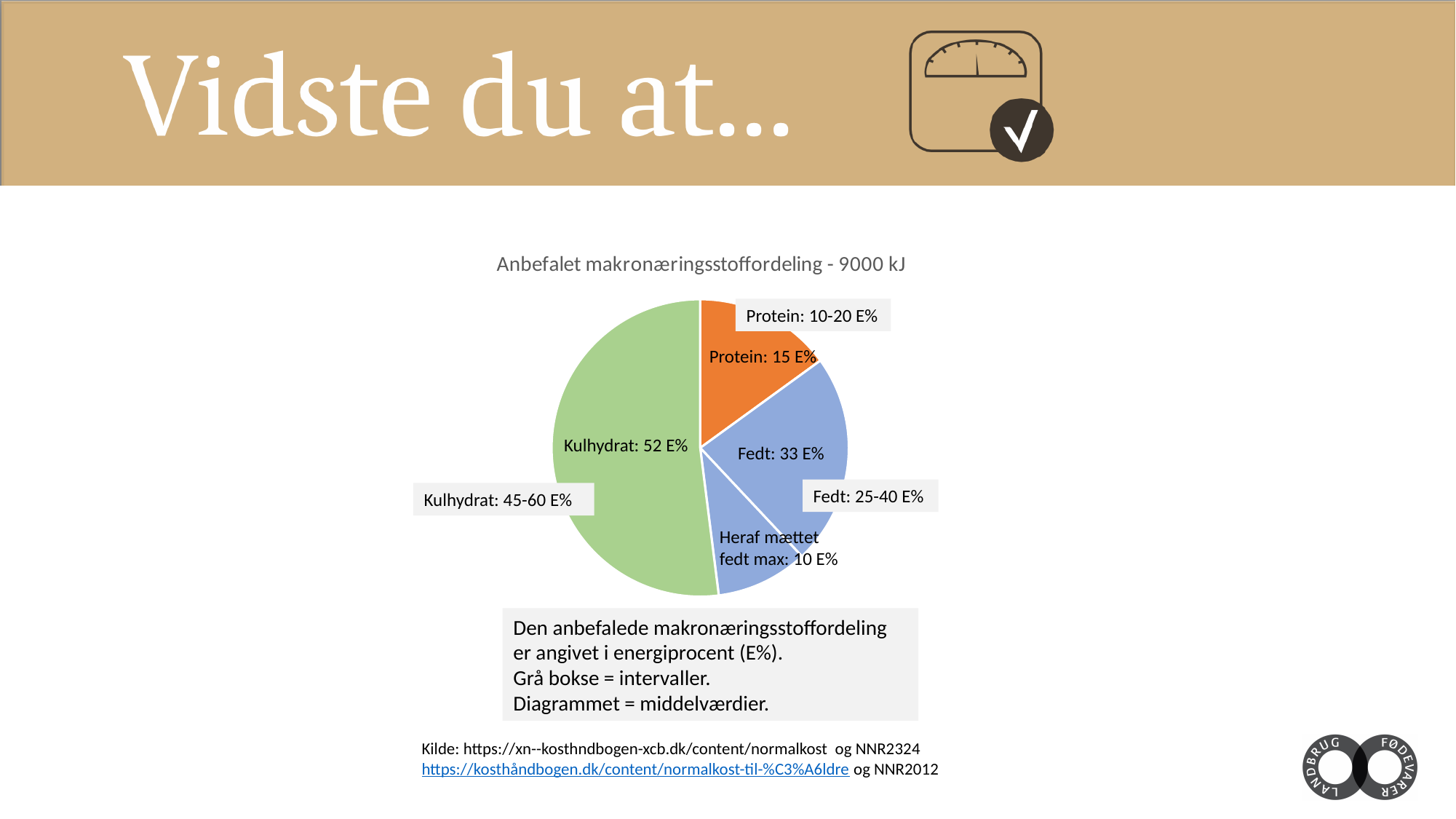
What is the maximum value given for 'Heraf mættet fedt' in the pie chart? 10 E% Which macronutrient has the largest slice of the pie chart? Kulhydrat What is the difference between the Kulhydrat value and the Fedt value in the pie chart? 19 E% What value is shown for Kulhydrat in the pie chart? 52 E% What share of the pie does Kulhydrat represent? 52 E% What is the title of the chart? Anbefalet makronæringsstoffordeling - 9000 kJ What interval is shown in the grey box for Fedt? 25-40 E% What type of chart is shown on the slide? pie chart What value is shown for Protein in the pie chart? 15 E% What value is shown for Fedt in the pie chart? 33 E% Which is larger in the pie chart, Fedt or Protein? Fedt